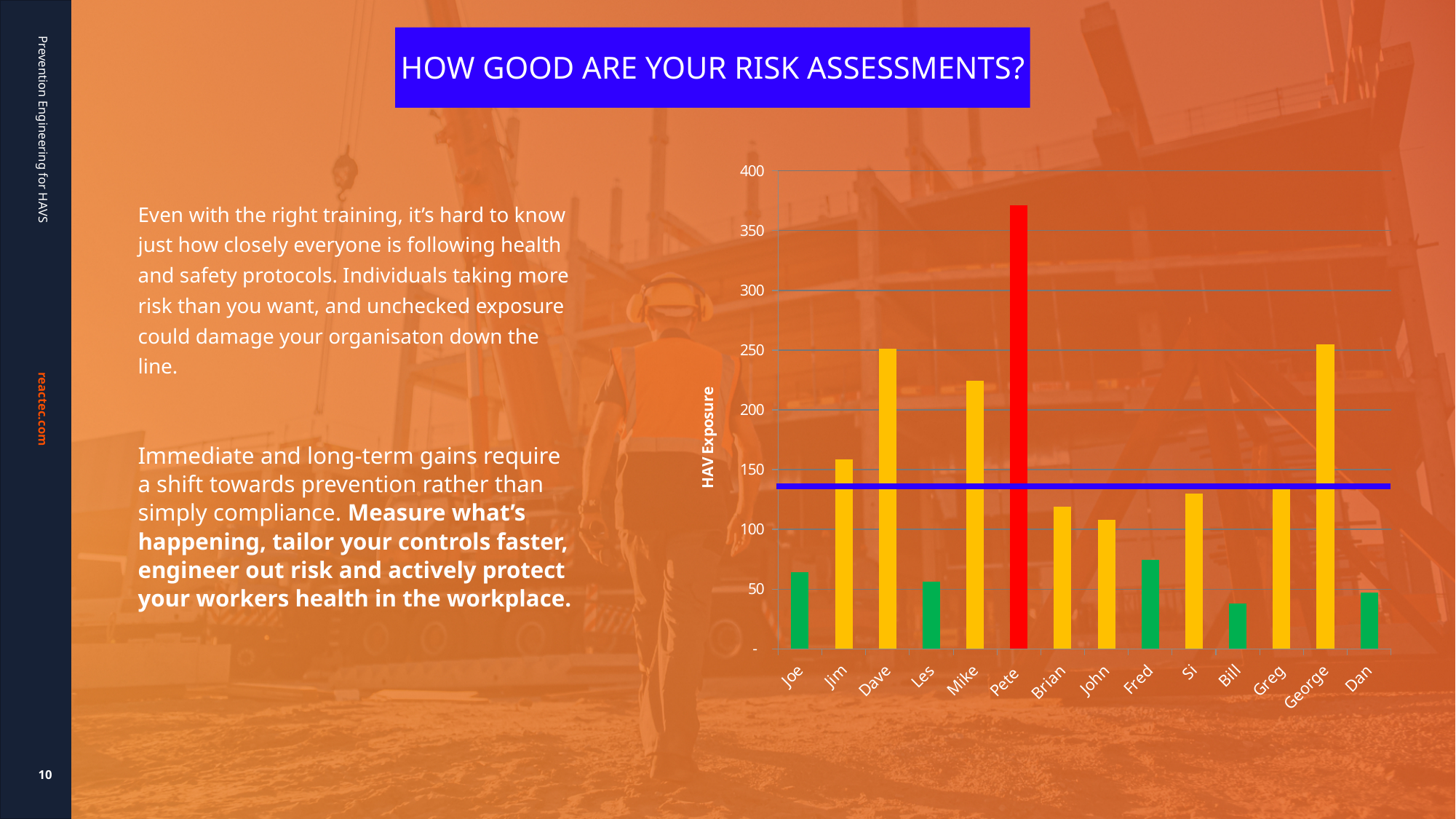
Which worker has the highest HAV Exposure in the chart? Pete Which worker has a higher HAV Exposure, Jim or Joe? Jim Is the HAV Exposure value for Pete greater or less than 350? greater Is the HAV Exposure value for Dave greater or less than 200? greater Is the HAV Exposure value for Bill greater or less than 50? less What kind of chart is shown on the slide? Bar chart How many workers (categories) are shown on the x axis of the chart? 14 What colour is the bar for Pete in the chart? Red What is the label on the vertical axis of the chart? HAV Exposure Which worker has a higher HAV Exposure, Dave or Mike? Dave